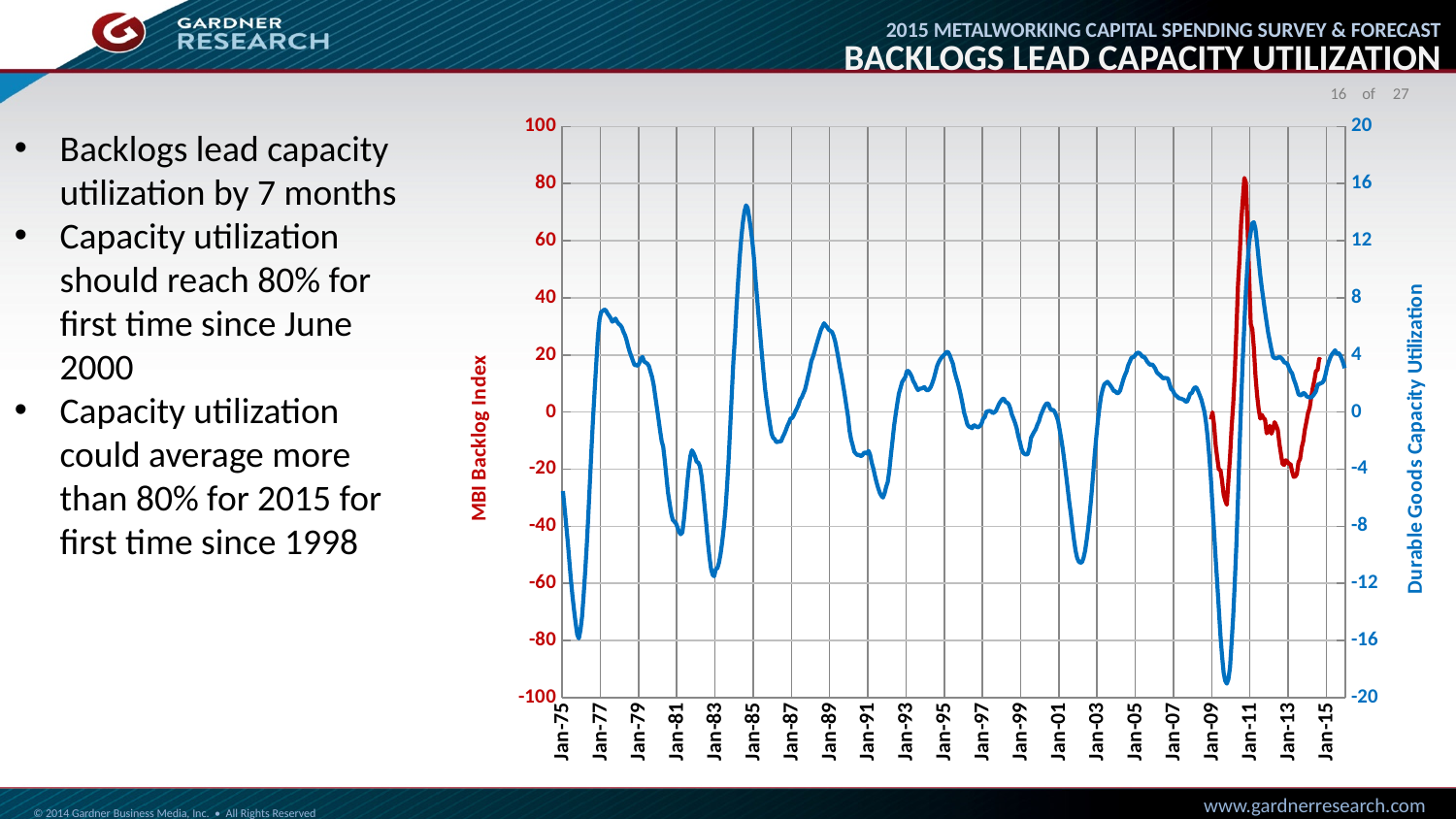
How many year labels are shown along the x axis of the chart? 21 What kind of chart is shown on the slide? line chart How many lines are plotted on the chart? 2 What is the title of the right vertical axis of the chart? Durable Goods Capacity Utilization What is the last year label on the x axis of the chart? Jan-15 What is the maximum value shown on the left vertical axis of the chart? 100 What is the first year label on the x axis of the chart? Jan-75 What is the title of the left vertical axis of the chart? MBI Backlog Index Does the Durable Goods Capacity Utilization line rise or fall between Jan-09 and Jan-11? rise What is the minimum value shown on the right vertical axis of the chart? -20 Is the lowest point of the Durable Goods Capacity Utilization line around Jan-09 greater or less than -16 on the right axis? less Is the peak of the Durable Goods Capacity Utilization line around Jan-85 greater or less than 12 on the right axis? greater